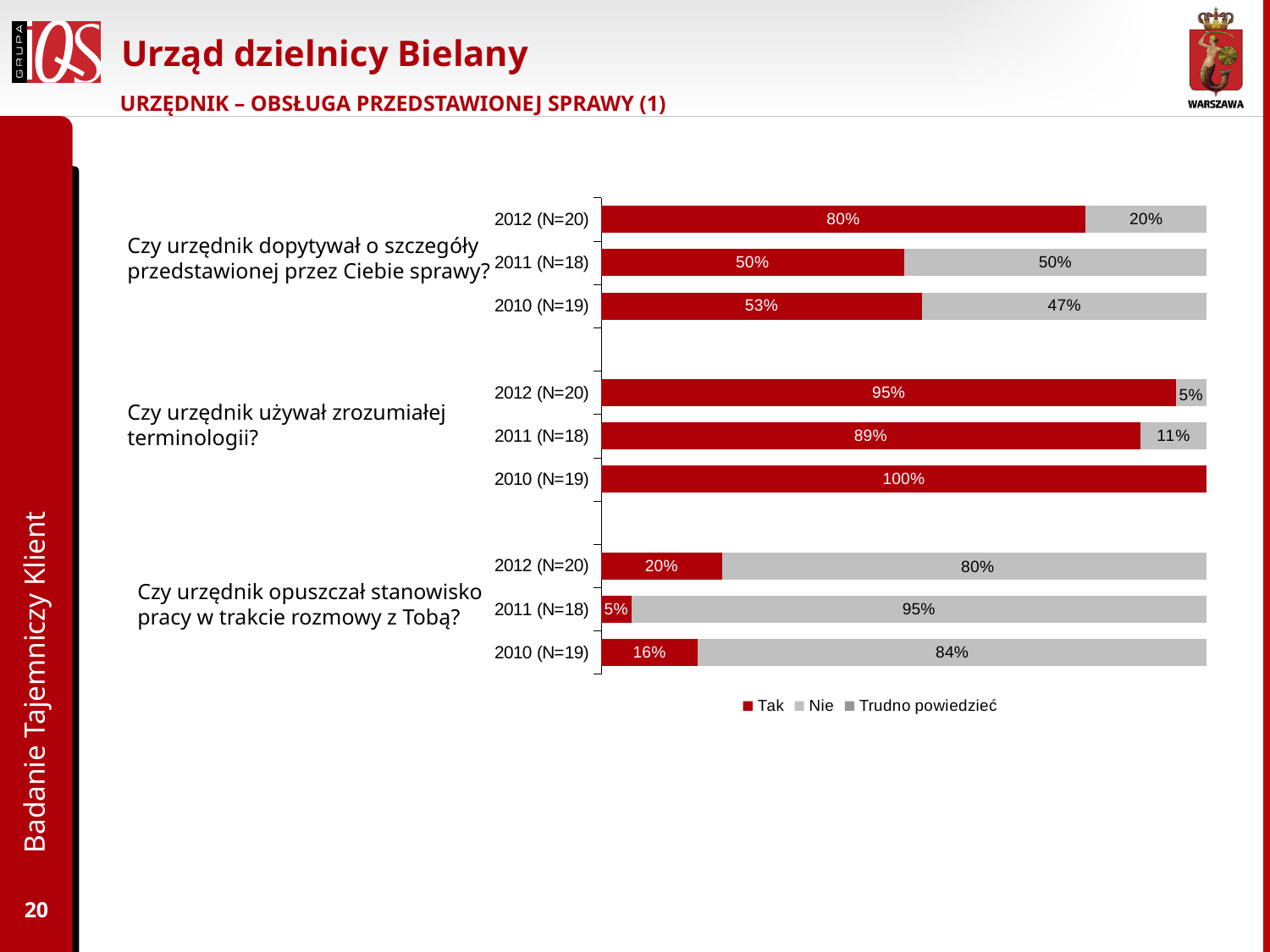
For the question "Czy urzędnik opuszczał stanowisko pracy w trakcie rozmowy z Tobą?", is the "Tak" share larger in 2012 (N=20) or in 2010 (N=19)? 2012 (N=20) What percentage answered "Nie" for 2011 (N=18) on the question "Czy urzędnik opuszczał stanowisko pracy w trakcie rozmowy z Tobą?"? 95% What is the difference between the "Tak" share in 2012 (N=20) and 2011 (N=18) for the question "Czy urzędnik dopytywał o szczegóły przedstawionej przez Ciebie sprawy?"? 30 percentage points For the question "Czy urzędnik używał zrozumiałej terminologii?", which year has the highest "Tak" share? 2010 (N=19) Which legend entry is shown in red? Tak What percentage answered "Tak" for 2012 (N=20) on the question "Czy urzędnik dopytywał o szczegóły przedstawionej przez Ciebie sprawy?"? 80% How many series does the legend list? 3 For the question "Czy urzędnik opuszczał stanowisko pracy w trakcie rozmowy z Tobą?", which year has the lowest "Tak" share? 2011 (N=18) How many bars are plotted in the chart in total? 9 What kind of chart is shown on the slide? Stacked bar chart What percentage answered "Tak" for 2011 (N=18) on the question "Czy urzędnik używał zrozumiałej terminologii?"? 89% What percentage answered "Nie" for 2010 (N=19) on the question "Czy urzędnik dopytywał o szczegóły przedstawionej przez Ciebie sprawy?"? 47%